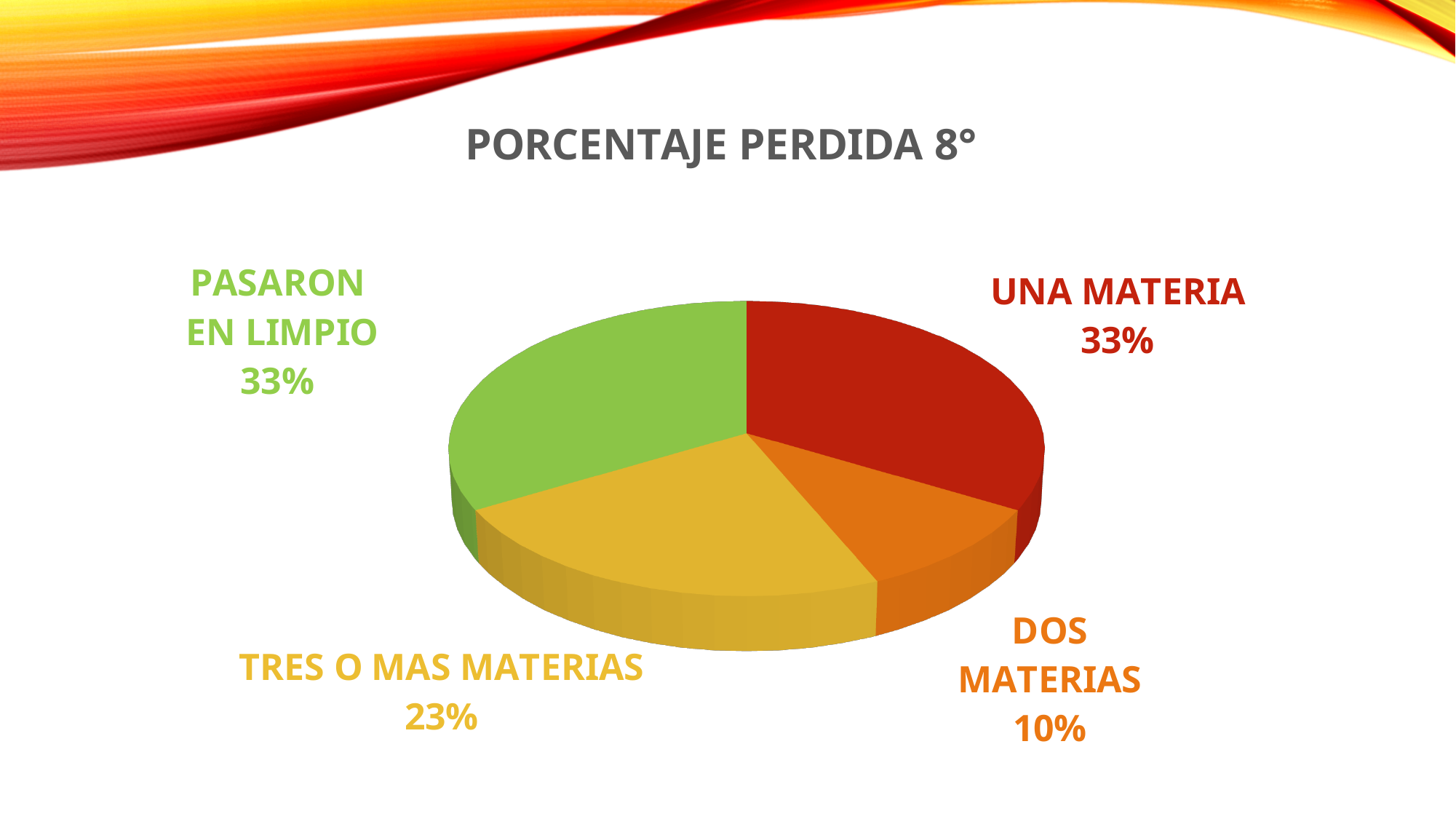
What colour is the slice for PASARON EN LIMPIO? green How many slices does the pie chart have? 4 Which category has the smallest share of the pie? DOS MATERIAS What type of chart is shown on the slide? pie chart What is the difference between the shares of UNA MATERIA and TRES O MAS MATERIAS? 10% What percentage is shown for TRES O MAS MATERIAS? 23% What percentage is shown for UNA MATERIA? 33% What is the difference between the shares of TRES O MAS MATERIAS and DOS MATERIAS? 13% What is the title of the chart? PORCENTAJE PERDIDA 8° What percentage is shown for PASARON EN LIMPIO? 33% What percentage is shown for DOS MATERIAS? 10% Which is larger, the share for TRES O MAS MATERIAS or the share for DOS MATERIAS? TRES O MAS MATERIAS